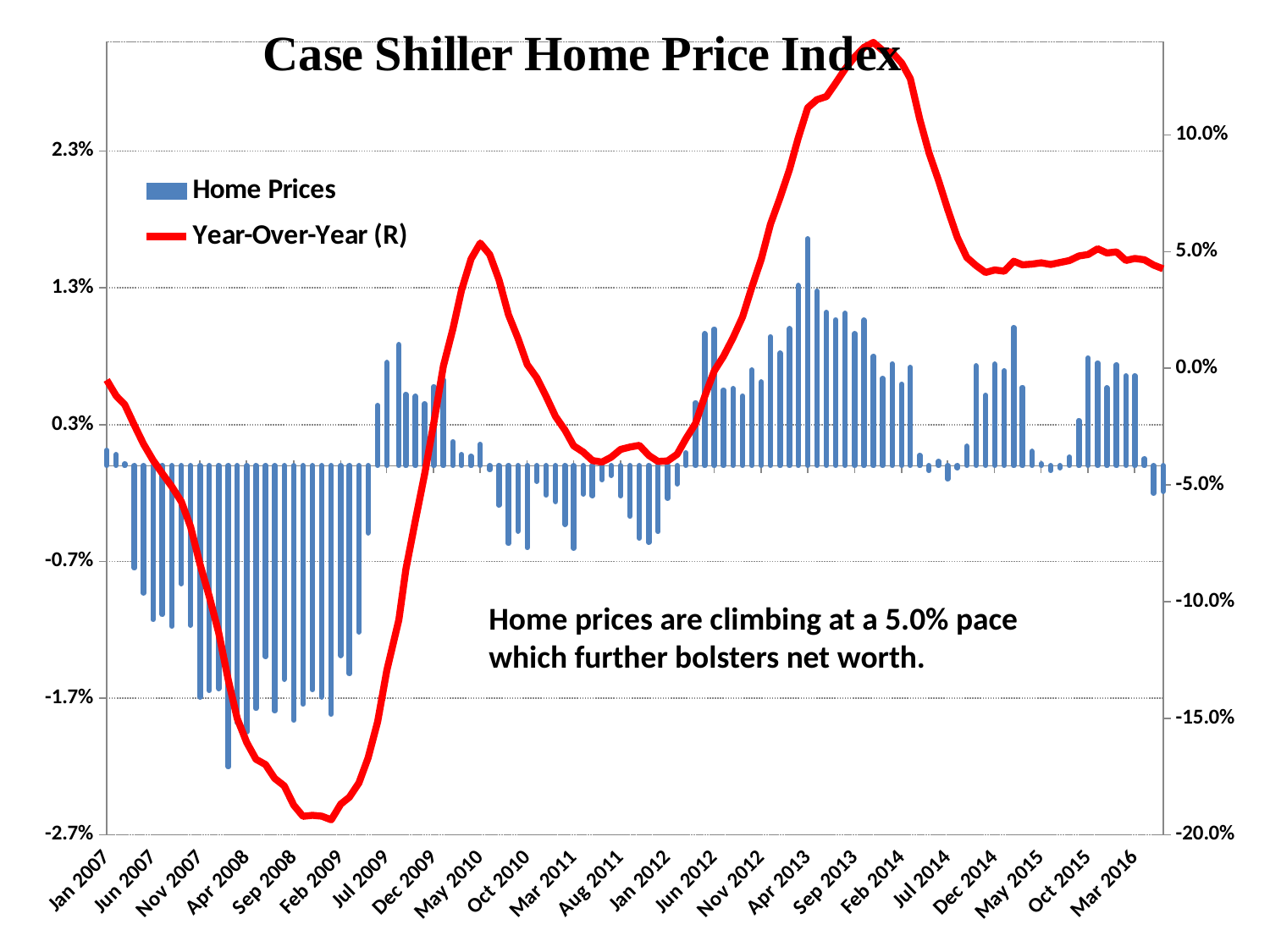
Does the Year-Over-Year line rise or fall between Feb 2009 and Sep 2013? rise Is the Year-Over-Year value around Apr 2013 greater or less than 10.0%? greater Does the Year-Over-Year line rise or fall between Feb 2014 and Jul 2014? fall Is the Year-Over-Year value around Feb 2009 greater or less than -15.0%? less What is the title of the chart? Case Shiller Home Price Index How many series does the legend list? 2 Is the highest Home Prices bar greater or less than 1.3%? greater What kind of chart is this? Combination bar and line chart Is the Year-Over-Year value higher around Sep 2013 or around Feb 2009? Sep 2013 Which series is plotted as a red line? Year-Over-Year (R)